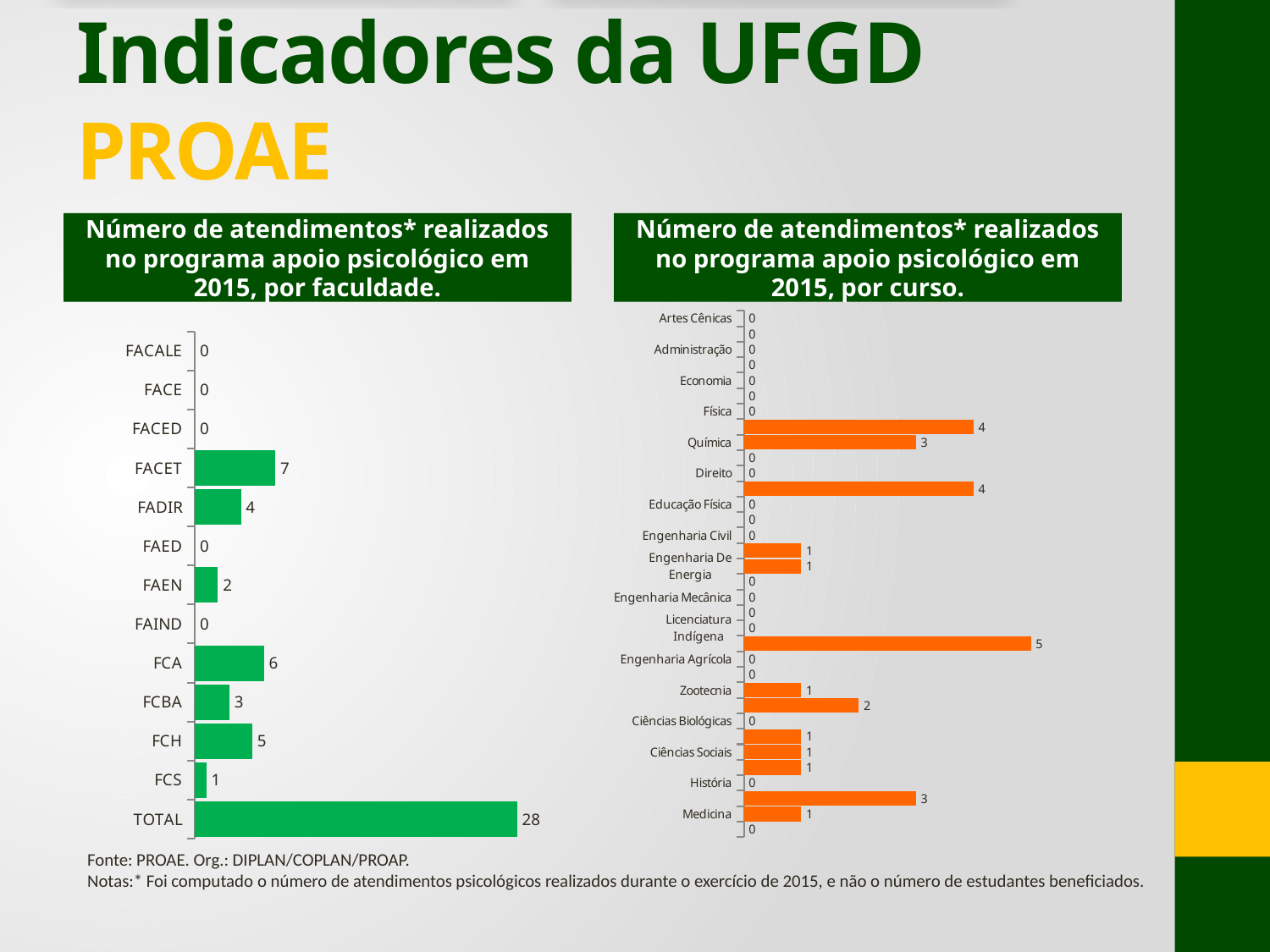
In the chart 'por faculdade' on the left, how many faculties have a value of 0? 5 In the chart 'por faculdade' on the left, what is the difference between the values for FACET and FADIR? 3 What type of chart is used in the chart 'por faculdade' on the left? Bar chart In the chart 'por faculdade' on the left, what is the value for TOTAL? 28 In the chart 'por faculdade' on the left, which faculty (excluding TOTAL) has the highest number of atendimentos? FACET In the chart 'por curso' on the right, what is the value for Medicina? 1 In the chart 'por faculdade' on the left, how many categories are shown on the axis, including TOTAL? 13 In the chart 'por faculdade' on the left, what is the value for FACET? 7 In the chart 'por faculdade' on the left, what is the value for FCA? 6 In the chart 'por faculdade' on the left, which is larger, the value for FCH or the value for FCBA? FCH What colour are the bars in the chart 'por curso' on the right? Orange In the chart 'por curso' on the right, what is the highest value labelled on any bar? 5